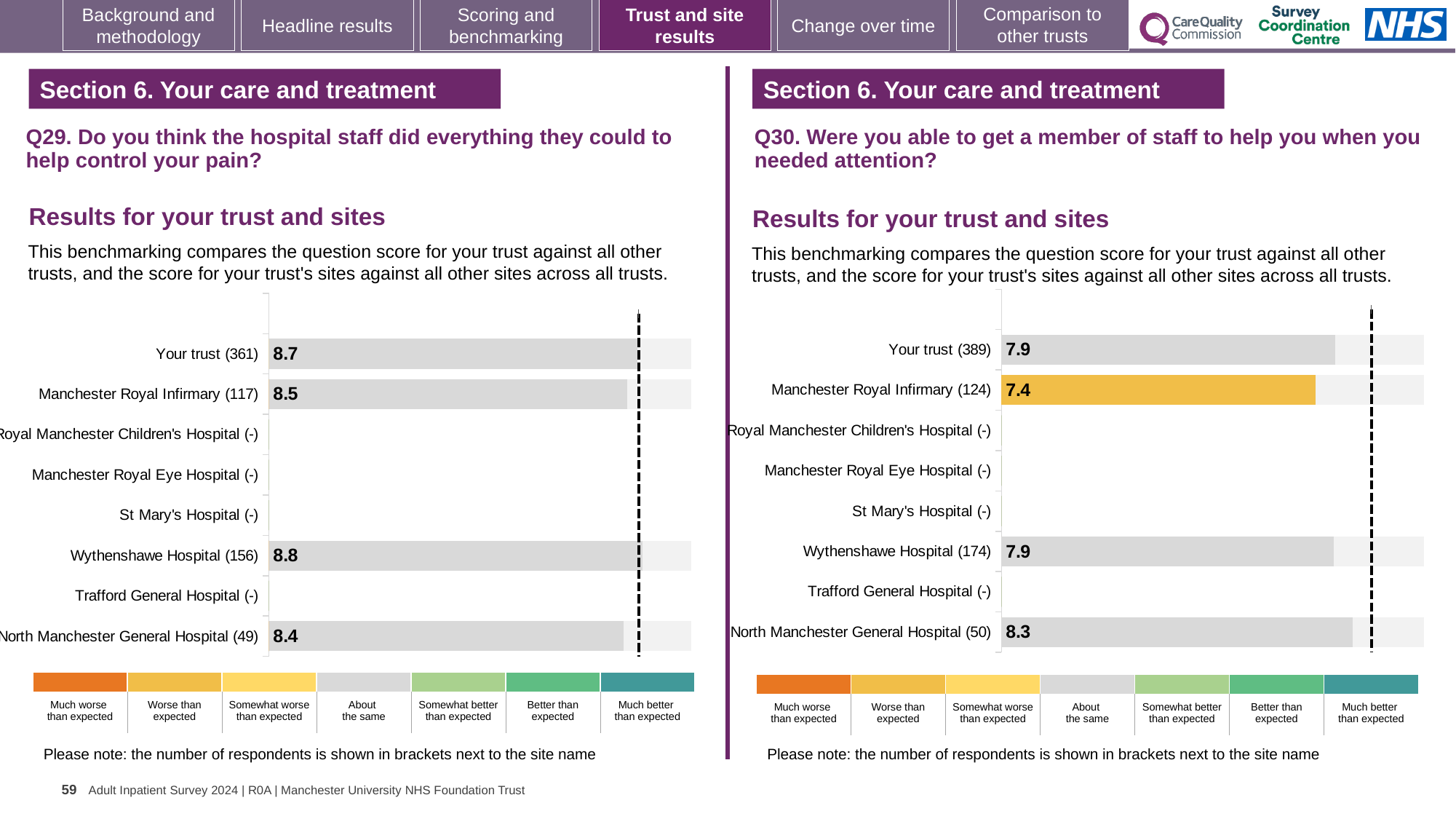
In the Q30 chart on the right, what is the difference between the scores for Your trust and Manchester Royal Infirmary? 0.5 In the Q30 chart on the right, which is larger: the score for Your trust or the score for Manchester Royal Infirmary? Your trust In the Q30 chart on the right, what is the score for Manchester Royal Infirmary (124)? 7.4 In the Q30 chart on the right, which benchmark category does the colour of the Manchester Royal Infirmary bar correspond to in the legend? Worse than expected In the Q29 chart on the left, what is the difference between the scores for Wythenshawe Hospital and North Manchester General Hospital? 0.4 In the Q29 chart on the left, which site with a plotted score has the lowest value? North Manchester General Hospital (49) In the Q29 chart on the left, what is the score for Your trust (361)? 8.7 How many site or trust categories are listed on the y axis of the Q29 chart on the left? 8 In the Q29 chart on the left, what is the score for Wythenshawe Hospital (156)? 8.8 What kind of chart is used for the Q30 results on the right? Bar chart In the Q30 chart on the right, which site with a plotted score has the highest value? North Manchester General Hospital (50) In the Q30 chart on the right, what is the score for North Manchester General Hospital (50)? 8.3